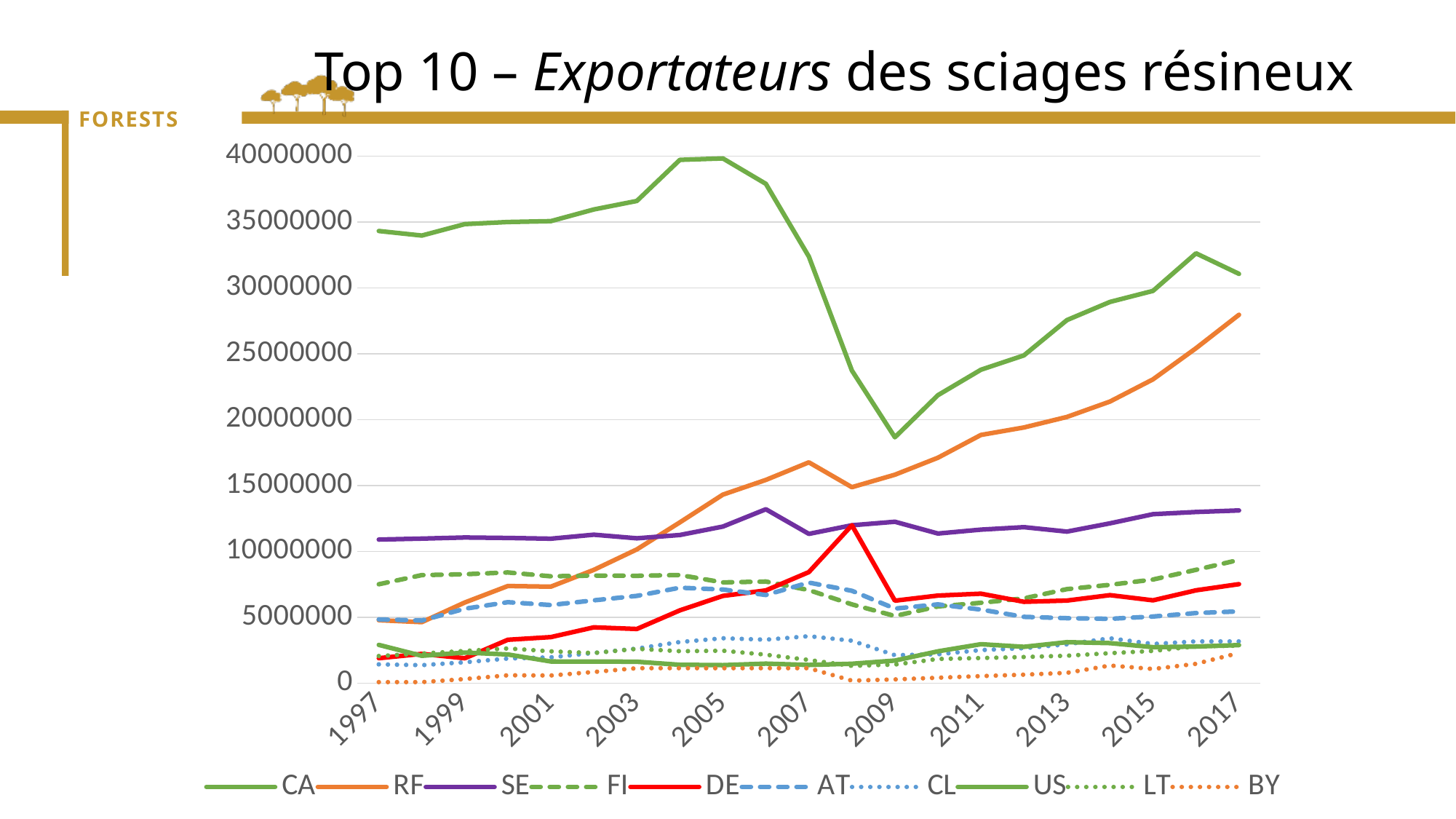
Which series has the highest value in 2005? CA Is the value for RF in 2017 greater or less than 25000000? greater Does the value for RF rise or fall overall from 1997 to 2017? rises What kind of chart is shown on the slide? line chart Which series has the higher value in 2017, RF or SE? RF Which series has the lowest value in 1997? BY What is the title of the slide? Top 10 – Exportateurs des sciages résineux Is the value for SE in 1997 greater or less than 10000000? greater How many year labels are shown on the x axis? 11 Is the value for CA in 2005 greater or less than 35000000? greater How many series does the legend list? 10